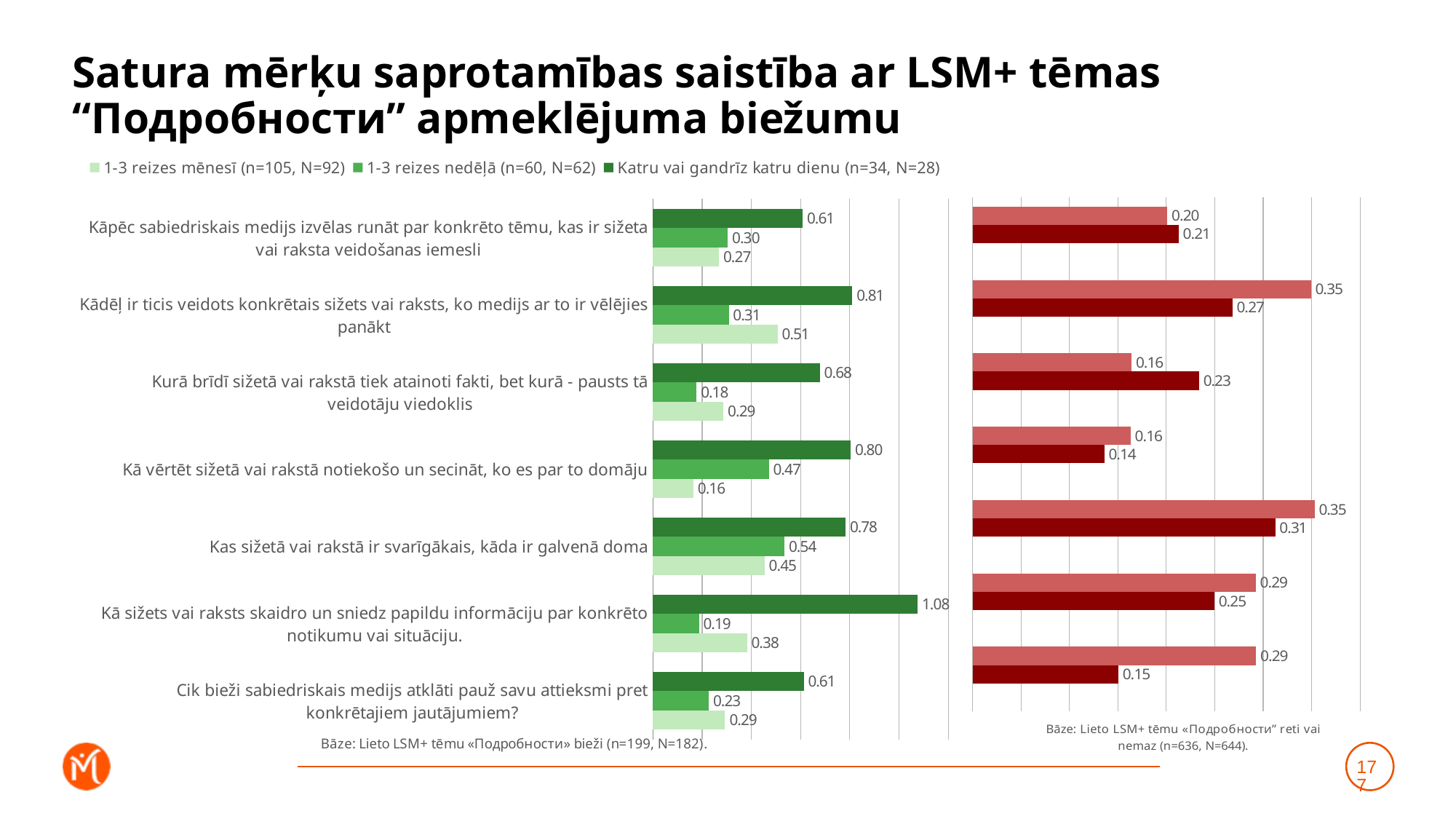
What is the highest value labeled on the right-hand red chart? 0.35 In the left green chart, what is the value for 'Katru vai gandrīz katru dienu' for the category 'Kā sižets vai raksts skaidro un sniedz papildu informāciju par konkrēto notikumu vai situāciju.'? 1.08 In the left green chart, what is the difference between the 'Katru vai gandrīz katru dienu' and '1-3 reizes mēnesī' values for 'Kas sižetā vai rakstā ir svarīgākais, kāda ir galvenā doma'? 0.33 What type of chart is the left green chart? Bar chart How many categories are shown in the left green chart? 7 In the left green chart, which category has the lowest value for the '1-3 reizes mēnesī' series? Kā vērtēt sižetā vai rakstā notiekošo un secināt, ko es par to domāju In the left green chart, what is the difference between the 'Katru vai gandrīz katru dienu' and '1-3 reizes nedēļā' values for 'Kādēļ ir ticis veidots konkrētais sižets vai raksts, ko medijs ar to ir vēlējies panākt'? 0.50 In the left green chart, what is the value for '1-3 reizes nedēļā' for the category 'Kas sižetā vai rakstā ir svarīgākais, kāda ir galvenā doma'? 0.54 How many series does the legend of the left green chart list? 3 In the left green chart, which category has the highest value for the 'Katru vai gandrīz katru dienu' series? Kā sižets vai raksts skaidro un sniedz papildu informāciju par konkrēto notikumu vai situāciju. In the left green chart, what is the value for '1-3 reizes mēnesī' for the category 'Kādēļ ir ticis veidots konkrētais sižets vai raksts, ko medijs ar to ir vēlējies panākt'? 0.51 In the left green chart, for 'Kurā brīdī sižetā vai rakstā tiek atainoti fakti, bet kurā - pausts tā veidotāju viedoklis', which series has the larger value: '1-3 reizes nedēļā' or '1-3 reizes mēnesī'? 1-3 reizes mēnesī